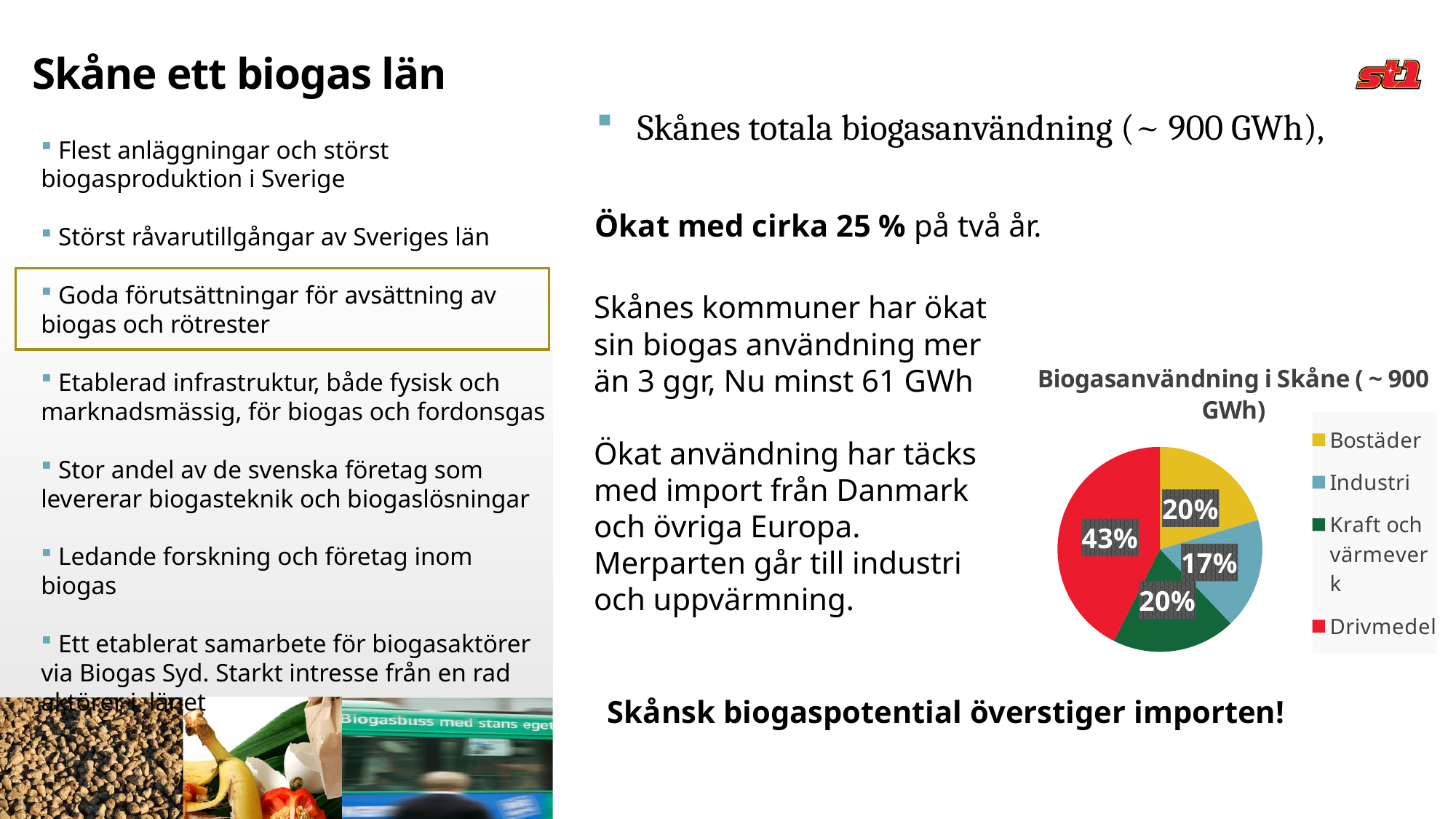
Which is larger, the share for Drivmedel or the share for Bostäder? Drivmedel What is the title of the pie chart? Biogasanvändning i Skåne ( ~ 900 GWh) What kind of chart is shown on the slide? pie chart What colour is the Drivmedel slice in the pie chart? red What is the value shown for Bostäder? 20% What is the value shown for Kraft och värmeverk? 20% Which category has the smallest slice of the pie? Industri What is the difference between the Drivmedel share and the Industri share? 26% What share of the pie does Drivmedel have? 43% How many categories does the legend of the pie chart list? 4 What share of the pie does Industri have? 17% Which category has the largest slice of the pie? Drivmedel